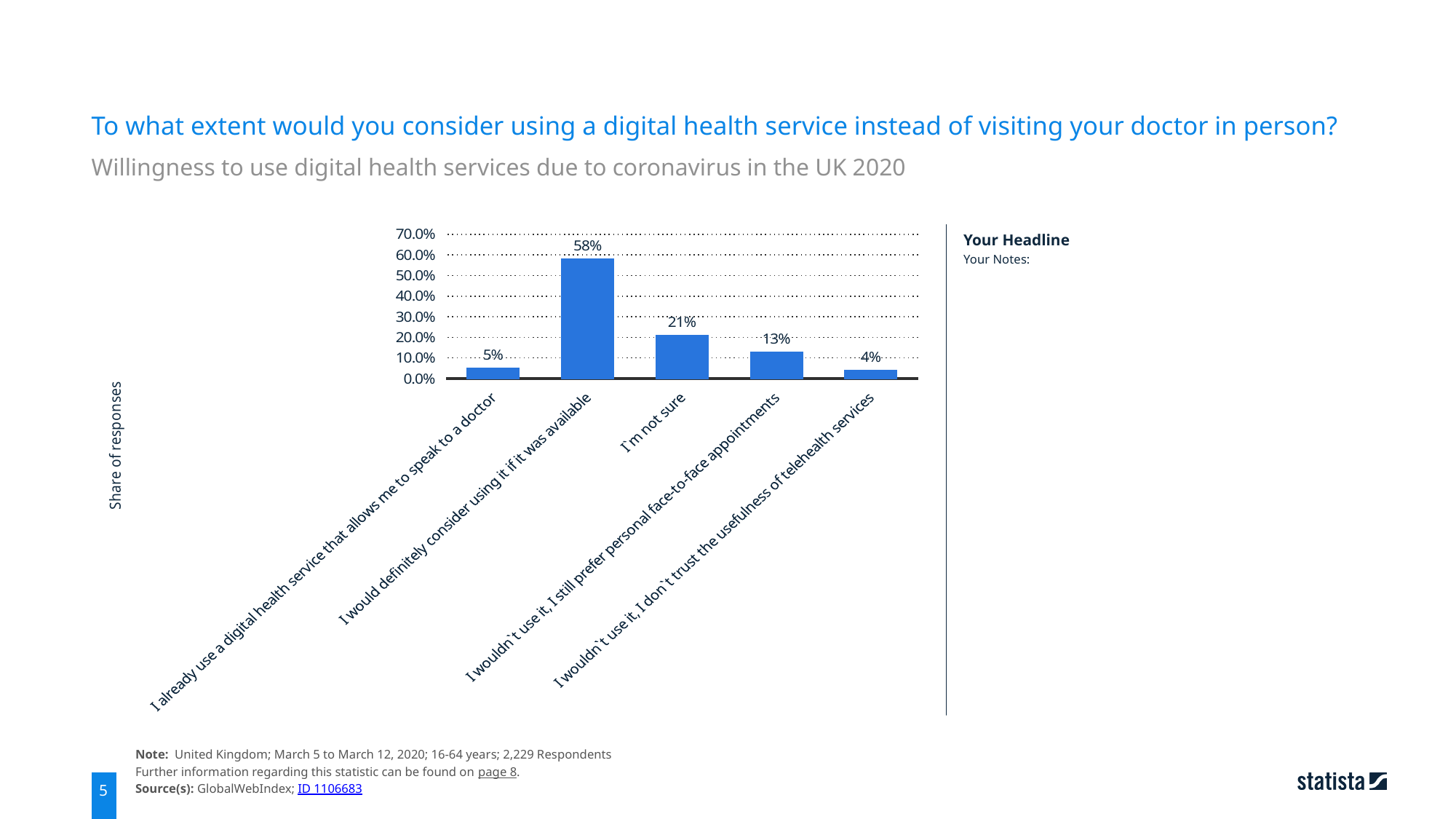
How many response categories are shown in the chart? 5 What share of respondents answered "I'm not sure"? 21% What is the label of the vertical axis? Share of responses Which is larger: the share for "I'm not sure" or the share for "I wouldn't use it, I still prefer personal face-to-face appointments"? I'm not sure What share of respondents said they already use a digital health service that allows them to speak to a doctor? 5% Which response category has the lowest share? I wouldn't use it, I don't trust the usefulness of telehealth services What share of respondents said they would definitely consider using a digital health service if it was available? 58% Which response category has the highest share? I would definitely consider using it if it was available What share of respondents said they wouldn't use it because they don't trust the usefulness of telehealth services? 4% What is the difference in share between "I would definitely consider using it if it was available" and "I'm not sure"? 37% What type of chart is shown on the slide? Bar chart Is the value for "I wouldn't use it, I still prefer personal face-to-face appointments" greater or less than 20.0%? less